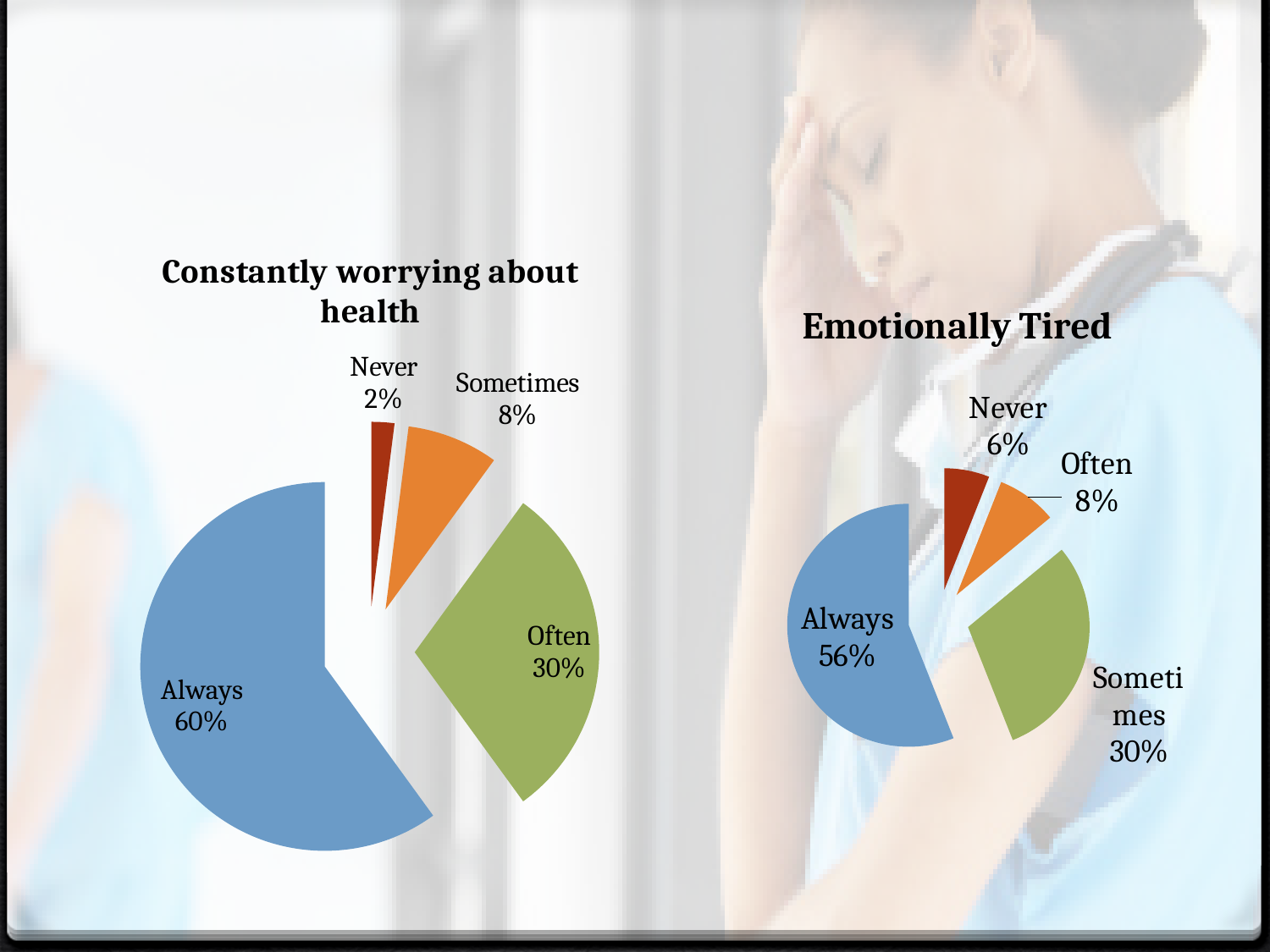
What is the title of the chart on the left side of the slide? Constantly worrying about health In the 'Emotionally Tired' chart, what percentage is labelled for Never? 6% In the 'Emotionally Tired' chart, what percentage is labelled for Always? 56% In the 'Constantly worrying about health' chart, what percentage is labelled for Always? 60% What kind of chart is the 'Emotionally Tired' chart? Pie chart In the 'Emotionally Tired' chart, which category has the largest slice? Always In the 'Constantly worrying about health' chart, what is the difference between the Sometimes and Never percentages? 6% In the 'Constantly worrying about health' chart, what percentage is labelled for Often? 30% In the 'Constantly worrying about health' chart, how many slices does the pie have? 4 In the 'Emotionally Tired' chart, which is larger, Often or Never? Often In the 'Emotionally Tired' chart, what is the difference between the Always and Sometimes percentages? 26% In the 'Constantly worrying about health' chart, which category has the smallest slice? Never